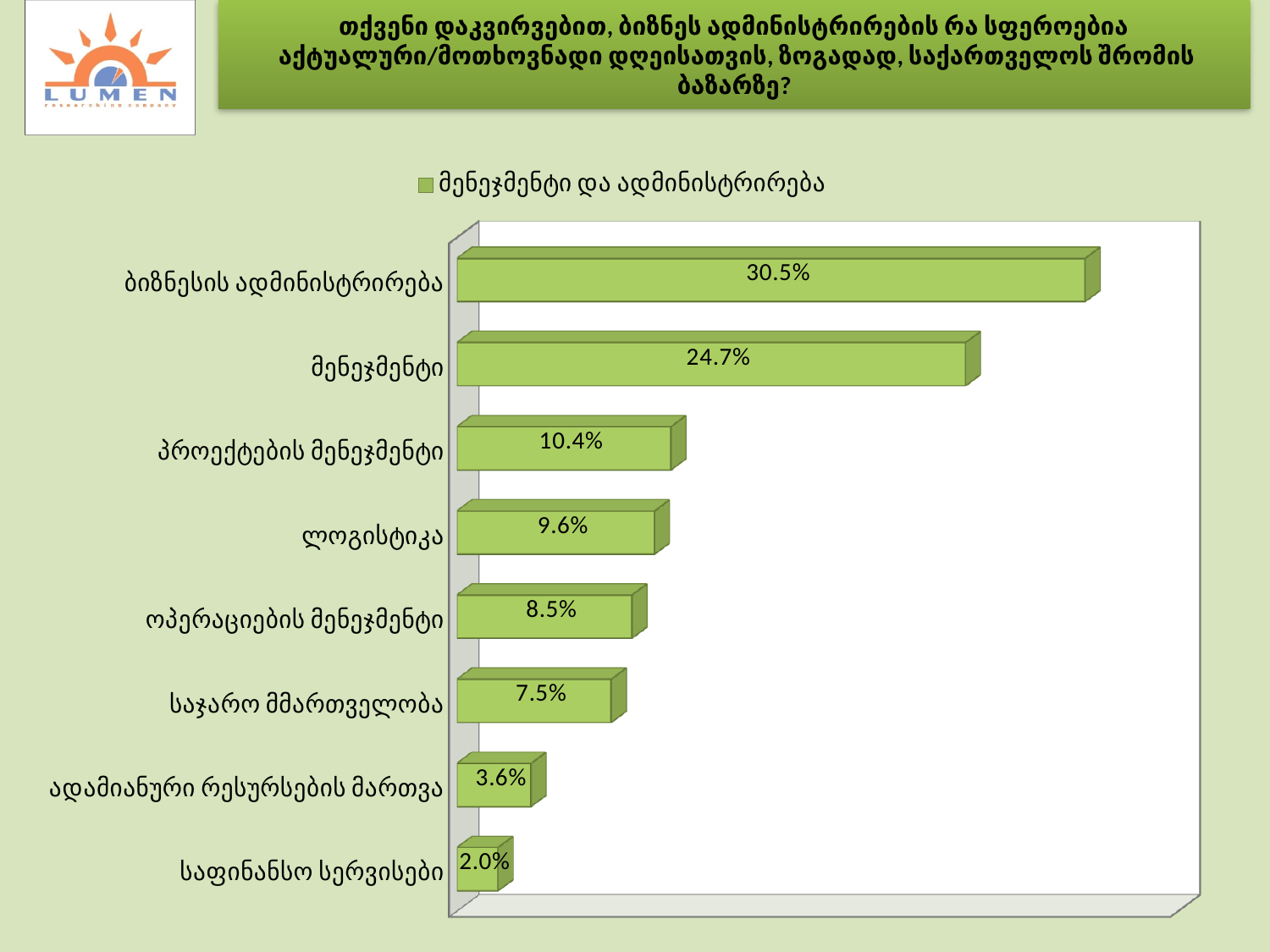
What is the difference between the values for ბიზნესის ადმინისტრირება and მენეჯმენტი? 5.8% How many categories are shown in the chart? 8 What is the value for ბიზნესის ადმინისტრირება? 30.5% What is the value for ადამიანური რესურსების მართვა? 3.6% What is the difference between the values for პროექტების მენეჯმენტი and საჯარო მმართველობა? 2.9% What is the legend entry shown above the chart? მენეჯმენტი და ადმინისტრირება Which is larger, the value for ოპერაციების მენეჯმენტი or the value for საჯარო მმართველობა? ოპერაციების მენეჯმენტი What is the value for ლოგისტიკა? 9.6% What kind of chart is shown on the slide? Bar chart Which category has the highest value? ბიზნესის ადმინისტრირება Which category has the lowest value? საფინანსო სერვისები How many series does the legend list? 1